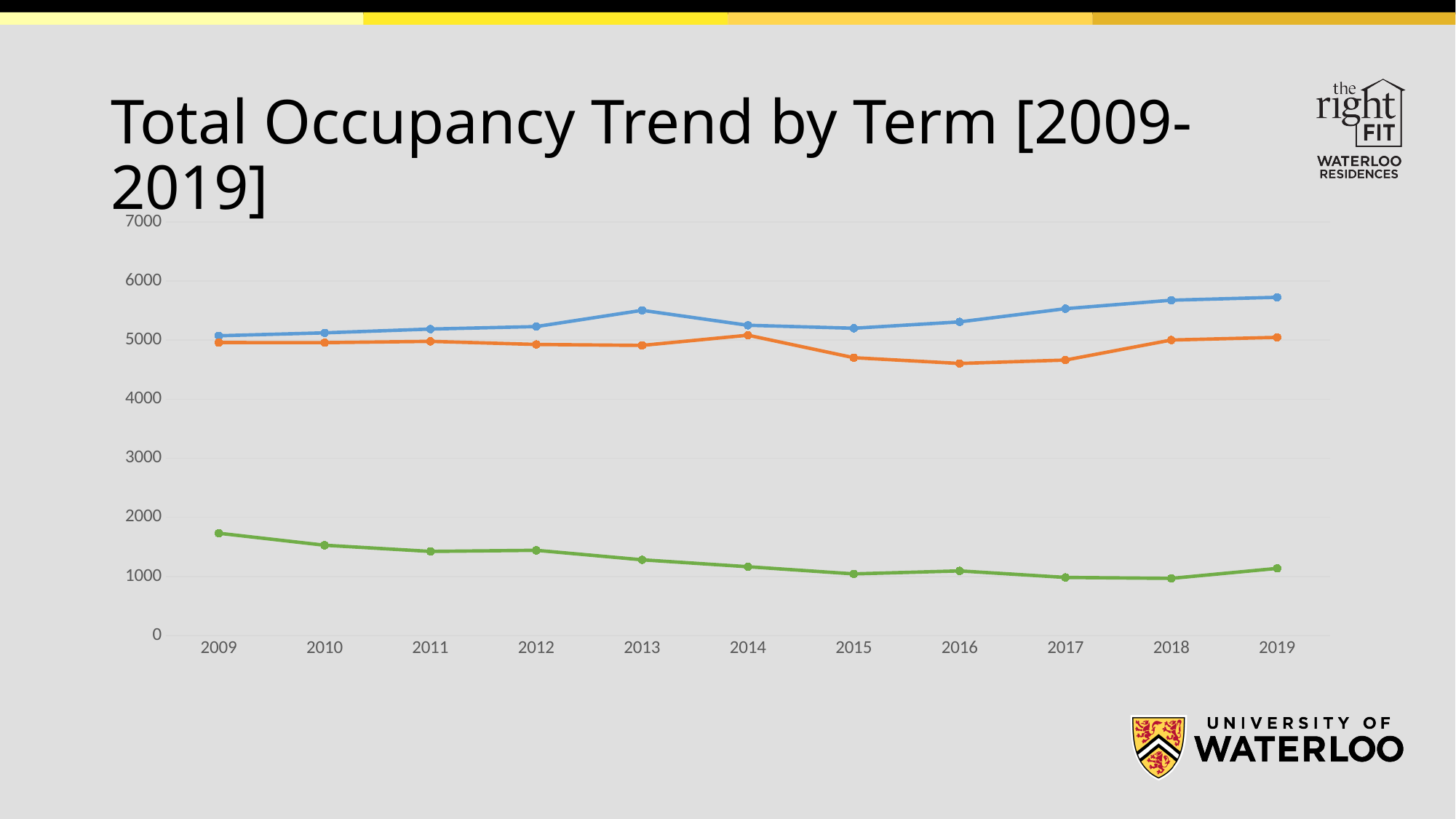
How many lines are plotted on the chart? 3 In 2013, which line has the larger value, the blue line or the orange line? blue line Does the green line rise or fall overall from 2009 to 2018? fall What kind of chart is shown on the slide? line chart Does the blue line rise or fall from 2015 to 2019? rise What is the title of the chart on the slide? Total Occupancy Trend by Term [2009-2019] In which year is the green line at its highest value? 2009 Is the value of the green line in 2009 greater or less than 1500? greater Is the value of the blue line in 2013 greater or less than 5000? greater Is the value of the green line in 2015 greater or less than 1500? less How many years are shown along the x axis of the chart? 11